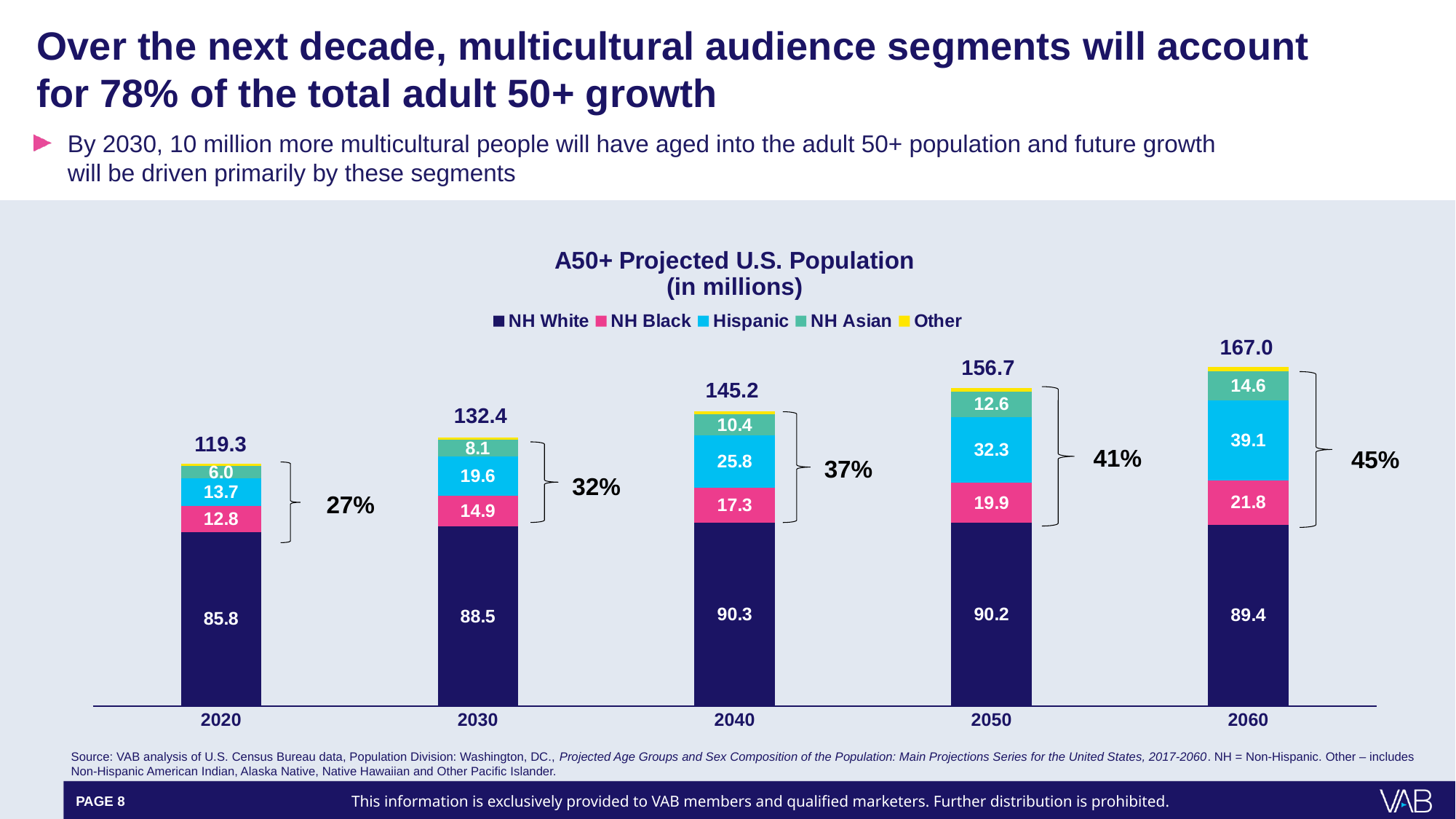
Which year has the lowest NH Asian value? 2020 How many series does the legend list? 5 Do the total bar values rise or fall from 2020 to 2060? rise What is the total of the stacked bar for 2050? 156.7 What percentage is annotated next to the 2030 bar? 32% In 2030, which is larger: the NH Black value or the Hispanic value? Hispanic What is the NH Black value for 2060? 21.8 What is the Hispanic value for 2040? 25.8 What is the difference between the Hispanic value in 2060 and in 2020? 25.4 What kind of chart is shown on the slide? bar chart How many years are shown along the x axis? 5 Which year has the highest total A50+ population? 2060